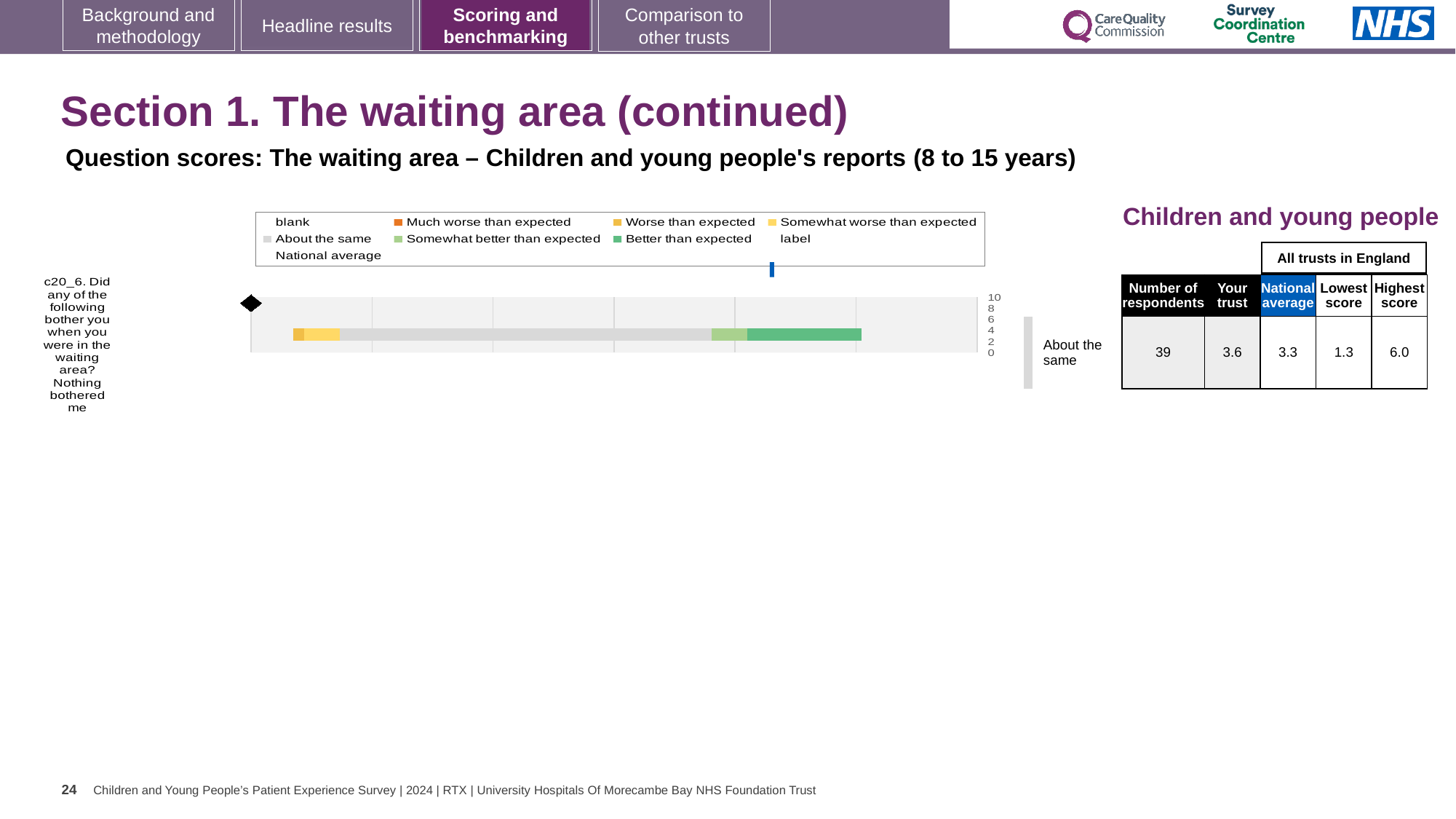
What is the highest score across all trusts in England for question c20_6? 6.0 How many entries does the chart's legend list? 9 How many respondents answered question c20_6? 39 What is the lowest score across all trusts in England for question c20_6? 1.3 What is the difference between the highest score (6.0) and the lowest score (1.3) for question c20_6? 4.7 What kind of chart is shown on the slide? bar chart What is the 'Your trust' score for question c20_6 in the table next to the chart? 3.6 What benchmark label is shown to the right of the bar for question c20_6? About the same What is the national average score for question c20_6 in the table next to the chart? 3.3 How many survey questions (categories) are plotted in the chart? 1 What is the highest tick value shown on the chart's axis? 10 Which is larger for question c20_6: the 'Your trust' score or the national average? Your trust